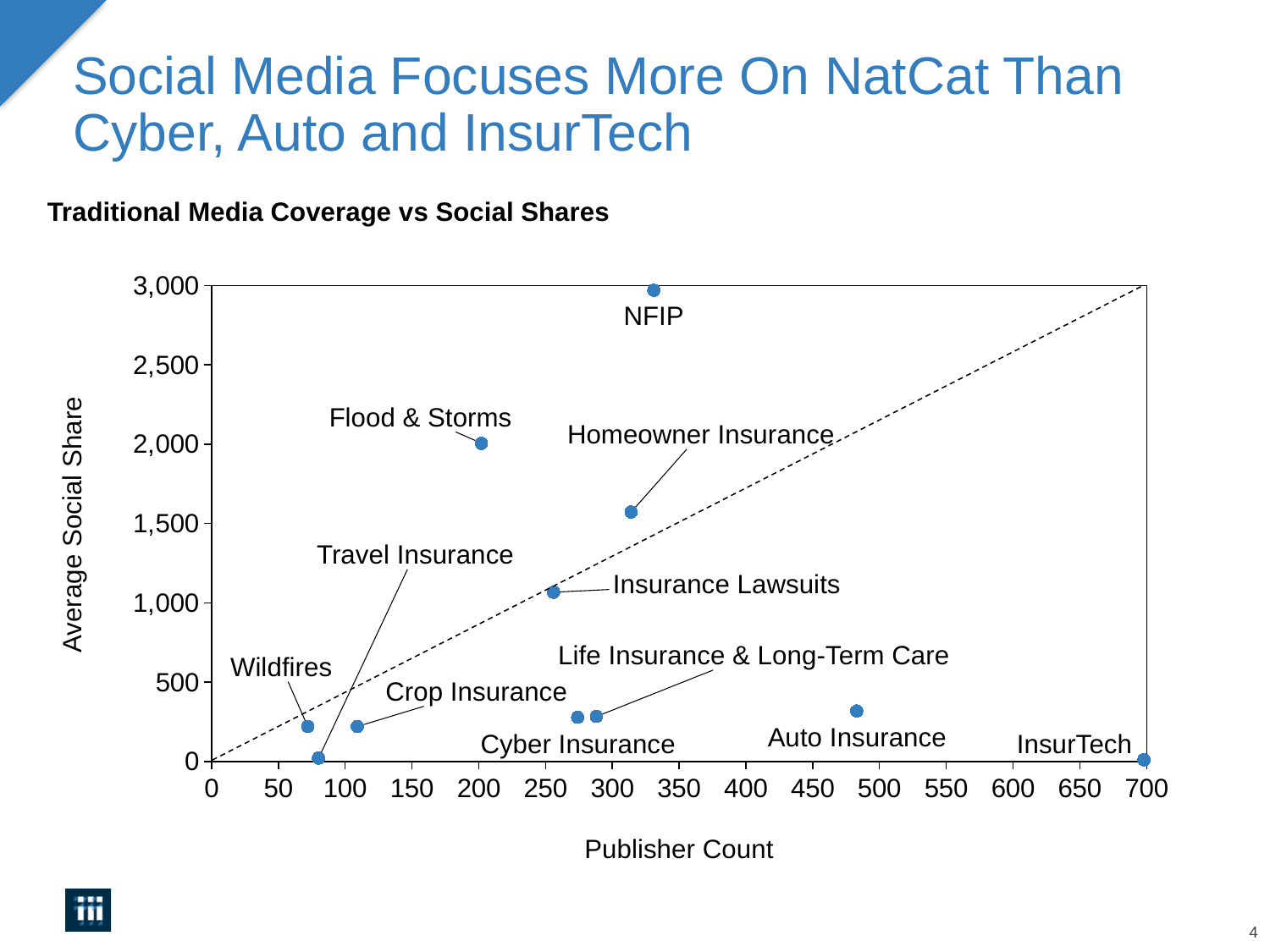
Which has a higher Average Social Share, Homeowner Insurance or Insurance Lawsuits? Homeowner Insurance How many labeled data points are plotted on the chart? 11 Is the Average Social Share for Auto Insurance greater or less than 500? less Which point has the highest Publisher Count? InsurTech Which has a higher Publisher Count, Auto Insurance or Cyber Insurance? Auto Insurance Is the Average Social Share for NFIP greater or less than 2,500? greater Which point has the highest Average Social Share? NFIP Is the Publisher Count for Flood & Storms greater or less than 250? less What kind of chart is shown on the slide? Scatter chart What is the label of the x axis? Publisher Count